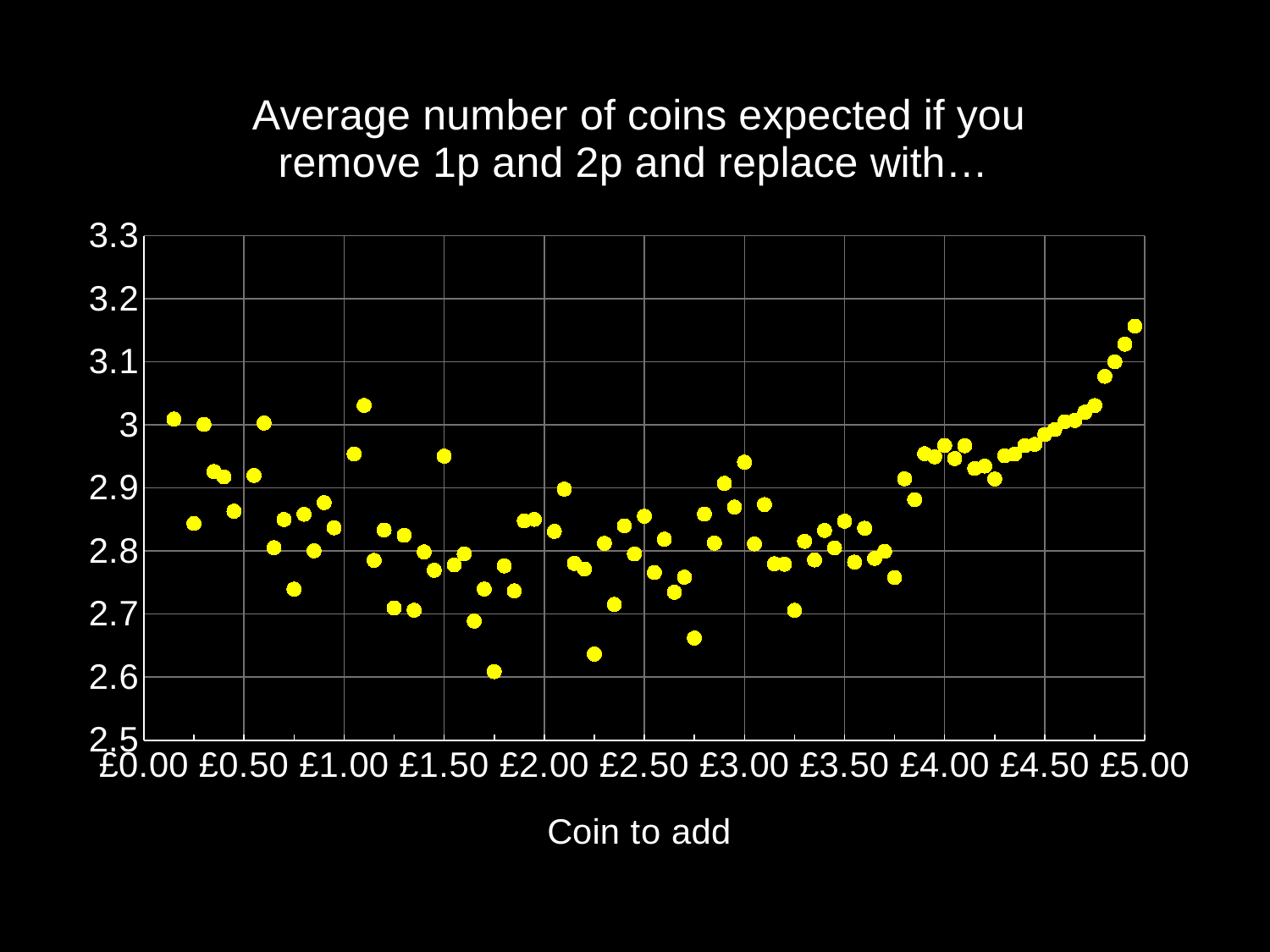
What kind of chart is shown on the slide? scatter chart What is the title of the chart? Average number of coins expected if you remove 1p and 2p and replace with… Is the highest point on the chart greater or less than 3.1? greater Is the value for the point at £2.50 greater or less than 3? less What is the label on the x axis of the chart? Coin to add Near which end of the x axis is the highest point on the chart found? near £5.00 Do the values rise or fall as the coin to add increases from £4.00 to £5.00? rise Between which two x-axis ticks does the lowest point on the chart lie? between £1.50 and £2.00 Is the lowest point on the chart greater or less than 2.7? less